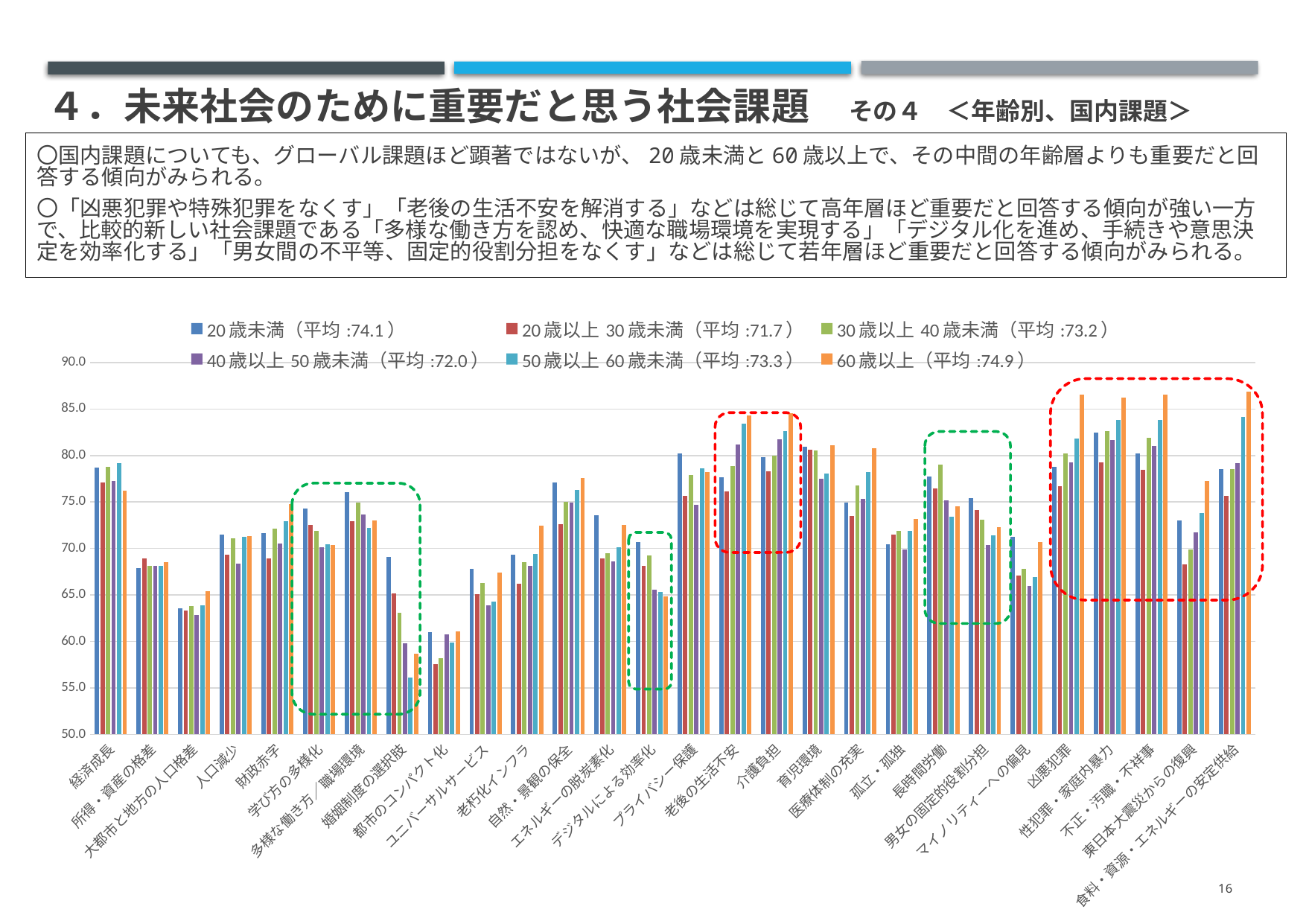
How many series does the legend list? 6 According to the legend, what is the average (平均) for the 20歳未満 series? 74.1 What colour are the bars for the 60歳以上 series? orange Which series has the lowest average (平均) shown in the legend? 20歳以上30歳未満 In the 凶悪犯罪 category, which is larger: the value for 60歳以上 or the value for 20歳以上30歳未満? 60歳以上 Which series has the highest average (平均) shown in the legend? 60歳以上 Is the value for 60歳以上 in the 老後の生活不安 category greater or less than 80.0? greater What kind of chart is shown on the slide? bar chart What is the difference between the legend averages of 60歳以上 (74.9) and 20歳以上30歳未満 (71.7)? 3.2 How many categories are shown along the x axis of the chart? 28 Is the value for 20歳未満 in the 都市のコンパクト化 category greater or less than 65.0? less According to the legend, what is the average (平均) for the 60歳以上 series? 74.9